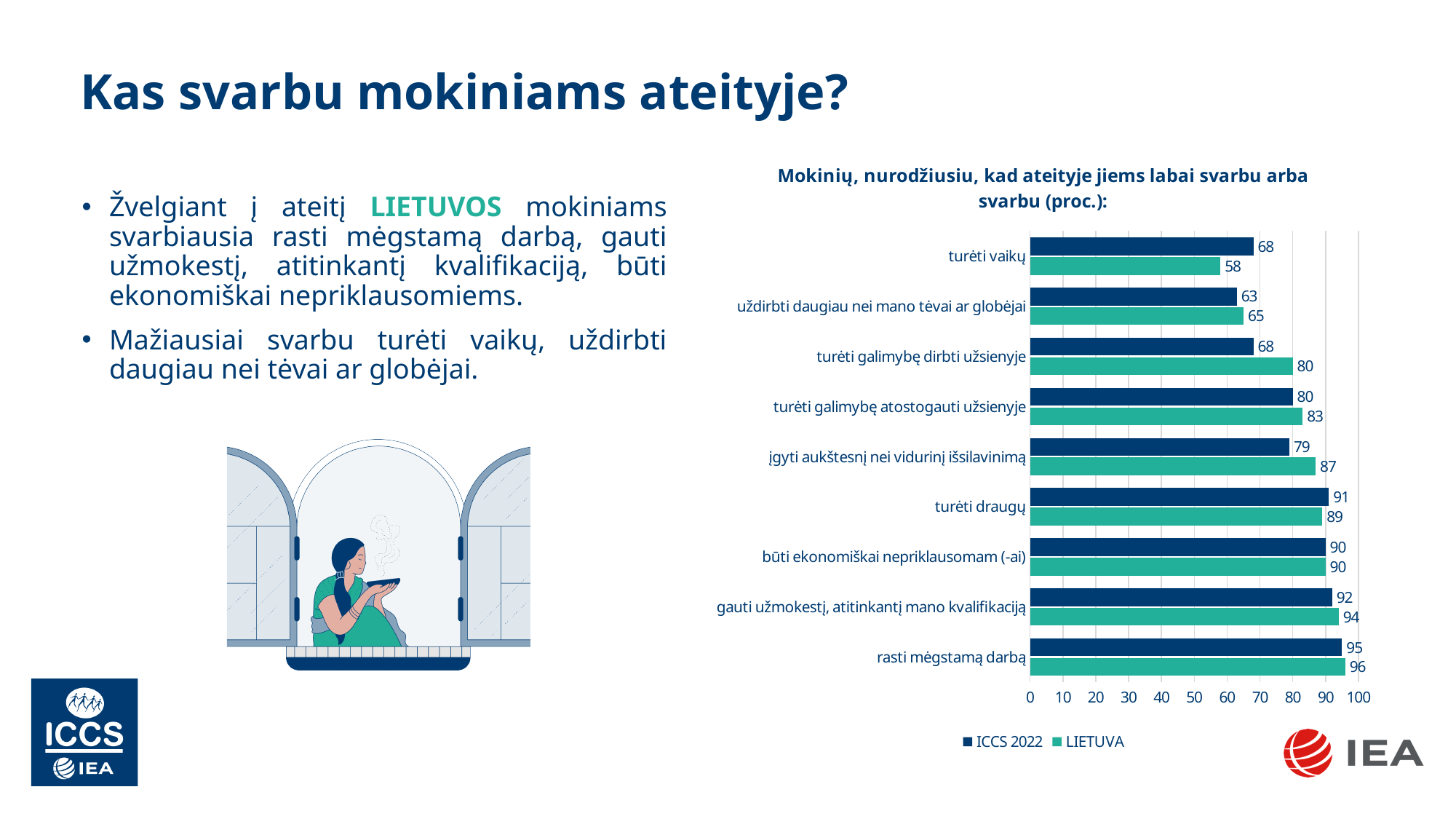
What is the ICCS 2022 value for "įgyti aukštesnį nei vidurinį išsilavinimą"? 79 Which category has the lowest LIETUVA value? turėti vaikų For "turėti draugų", which series has the larger value, ICCS 2022 or LIETUVA? ICCS 2022 What is the difference between the LIETUVA and ICCS 2022 values for "turėti vaikų"? 10 What is the difference between the LIETUVA and ICCS 2022 values for "turėti galimybę dirbti užsienyje"? 12 What type of chart is shown on the slide? bar chart How many categories are shown in the chart? 9 What is the LIETUVA value for "turėti vaikų"? 58 How many series does the legend list? 2 Which category has the highest LIETUVA value? rasti mėgstamą darbą What is the LIETUVA value for "turėti galimybę dirbti užsienyje"? 80 Which category has the lowest ICCS 2022 value? uždirbti daugiau nei mano tėvai ar globėjai